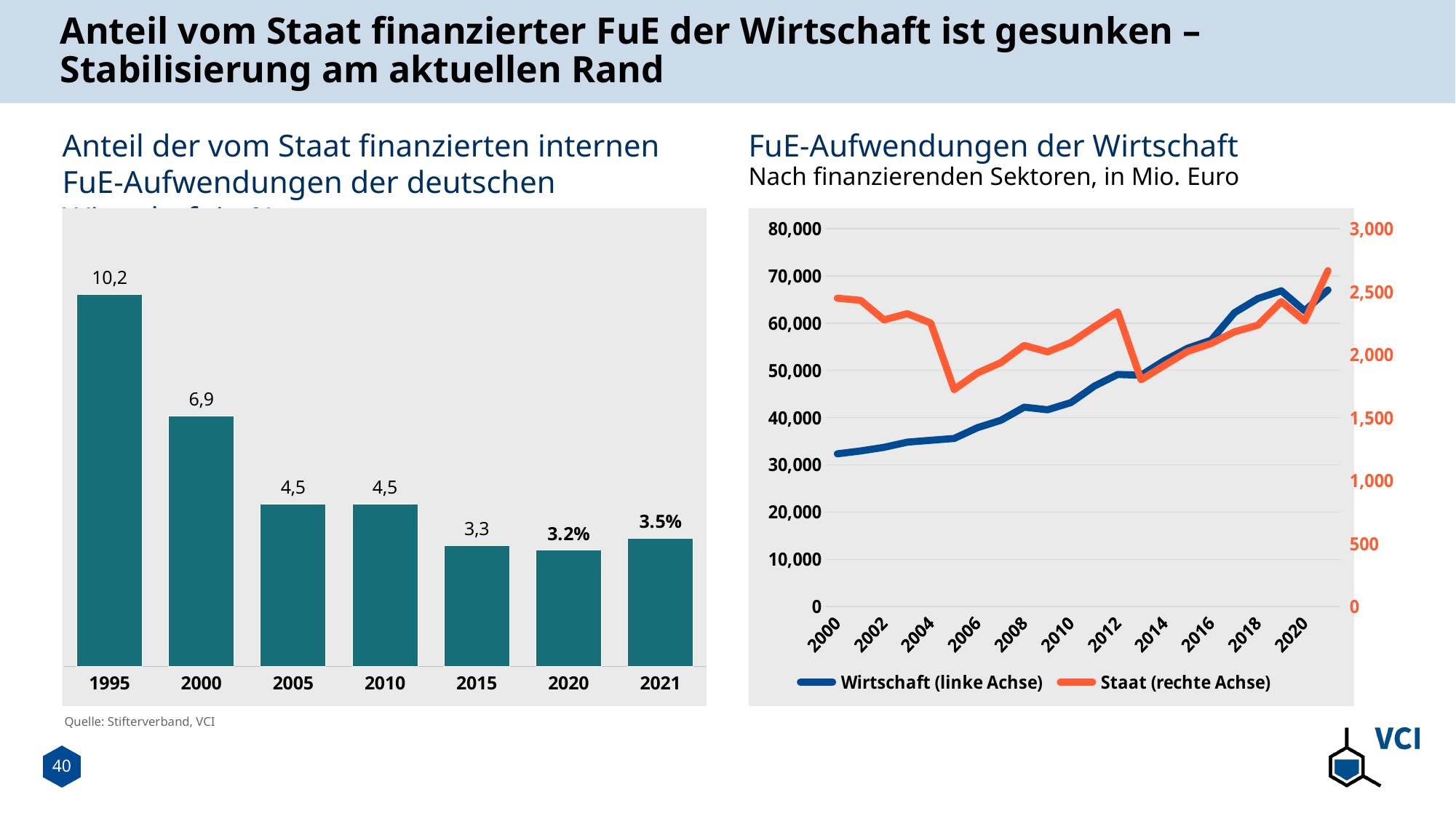
How many series does the legend of the chart 'FuE-Aufwendungen der Wirtschaft' list? 2 On the chart 'FuE-Aufwendungen der Wirtschaft', is the value for Wirtschaft in 2000 greater or less than 40,000? less What kind of chart is the chart titled 'FuE-Aufwendungen der Wirtschaft'? line chart On the left bar chart, what is the difference between the values for 1995 and 2015? 6,9 On the left bar chart, which year has the highest value? 1995 On the left bar chart, what is the value for 2021? 3.5% On the chart 'FuE-Aufwendungen der Wirtschaft', which series is plotted on the right axis? Staat How many bars are shown on the left bar chart? 7 On the left bar chart, what is the value for 1995? 10,2 On the left bar chart, which year has the lowest value? 2020 On the chart 'FuE-Aufwendungen der Wirtschaft', does the Wirtschaft series generally rise or fall from 2000 to 2021? rise On the left bar chart, which is larger, the value for 2000 or the value for 2005? 2000